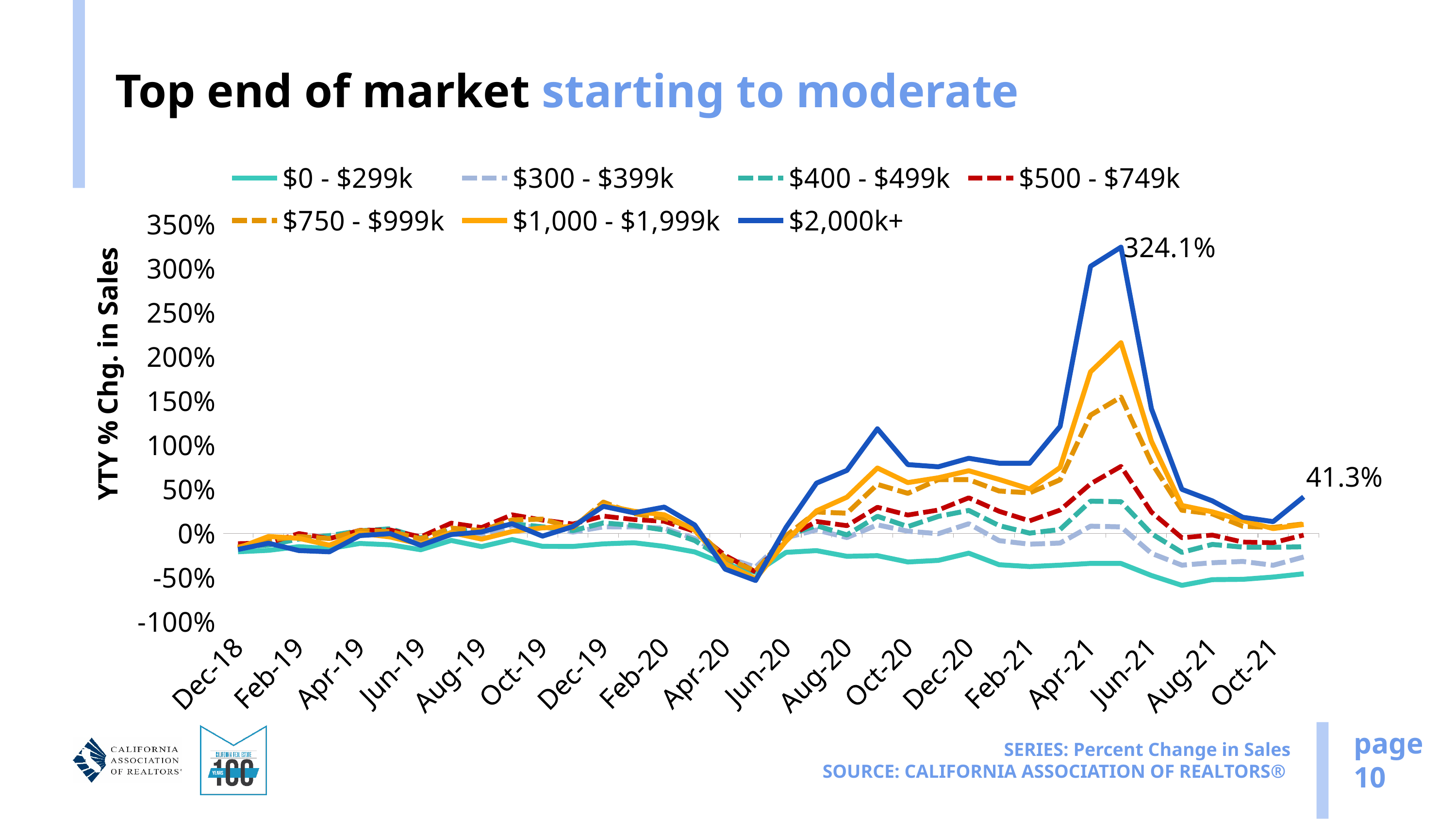
Which price segment has the lowest value at the right end of the chart (Oct-21 onward)? $0 - $299k What is the value labeled at the end of the $2,000k+ line? 41.3% What is the peak value labeled on the $2,000k+ line? 324.1% How many series does the legend list? 7 Is the value for $2,000k+ at Apr-21 greater or less than 100%? greater Is the peak value of the $1,000 - $1,999k line greater or less than 200%? greater Which price segment reaches the highest year-to-year percent change in sales on the chart? $2,000k+ What type of chart is shown on the slide? line chart Is the value for $0 - $299k at Jun-21 greater or less than 0%? less What is the difference between the labeled peak value (324.1%) and the labeled final value (41.3%) of the $2,000k+ line? 282.8% What is the label on the vertical axis of the chart? YTY % Chg. in Sales At Jun-21, which is higher: the $2,000k+ line or the $500 - $749k line? $2,000k+